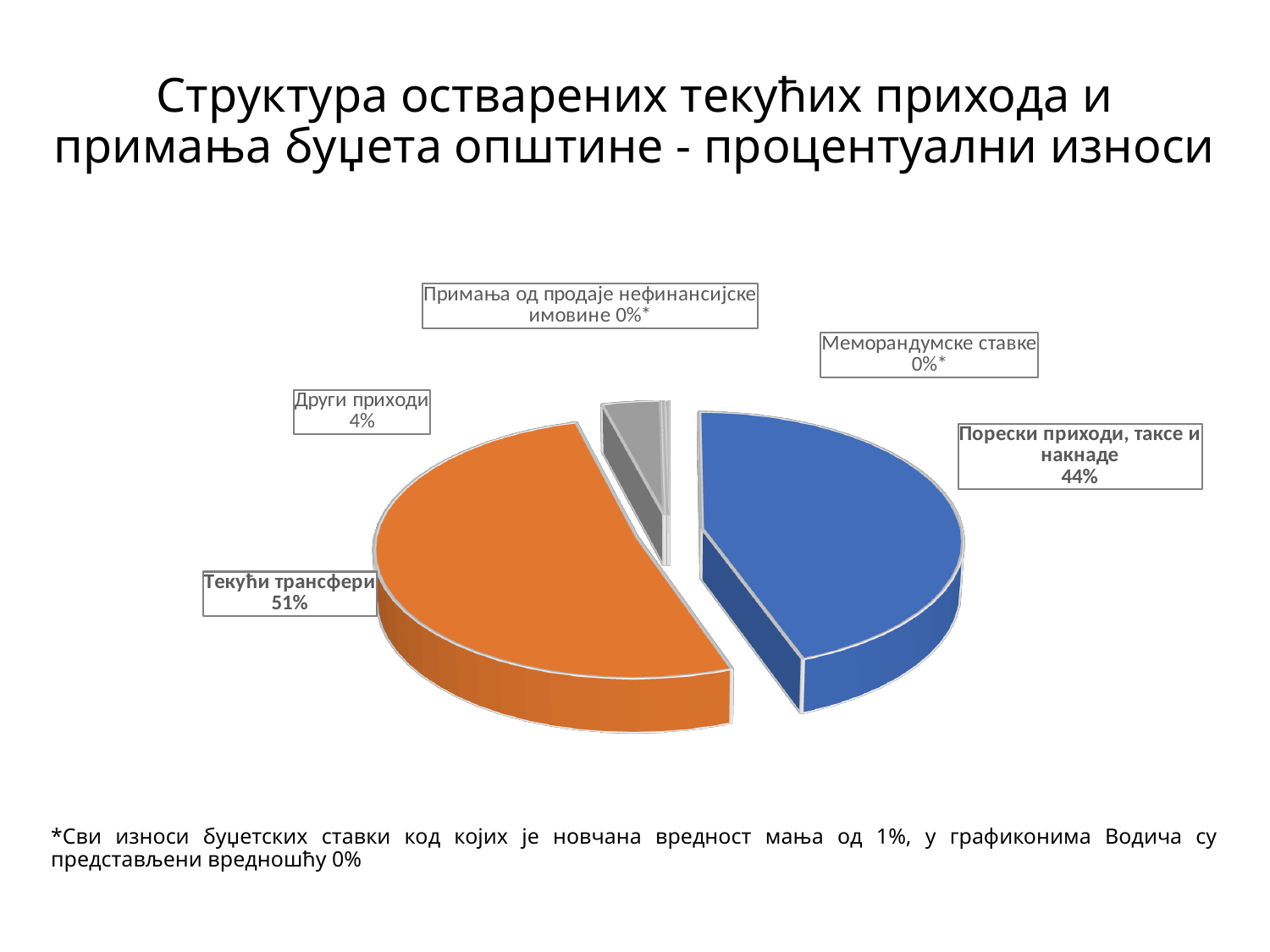
What value is shown for Примања од продаје нефинансијске имовине? 0%* What share of the pie does Порески приходи, таксе и накнаде have? 44% What share of the pie does Други приходи have? 4% What kind of chart is shown on the slide? pie chart Which is larger, Текући трансфери or Порески приходи, таксе и накнаде? Текући трансфери What is the title of the slide? Структура остварених текућих прихода и примања буџета општине - процентуални износи What value is shown for Меморандумске ставке? 0%* How many categories are labelled on the pie chart? 5 What share of the pie does Текући трансфери have? 51% What is the difference in percentage points between Текући трансфери and Порески приходи, таксе и накнаде? 7 Which category has the largest share of the pie? Текући трансфери What colour is the slice for Текући трансфери? orange